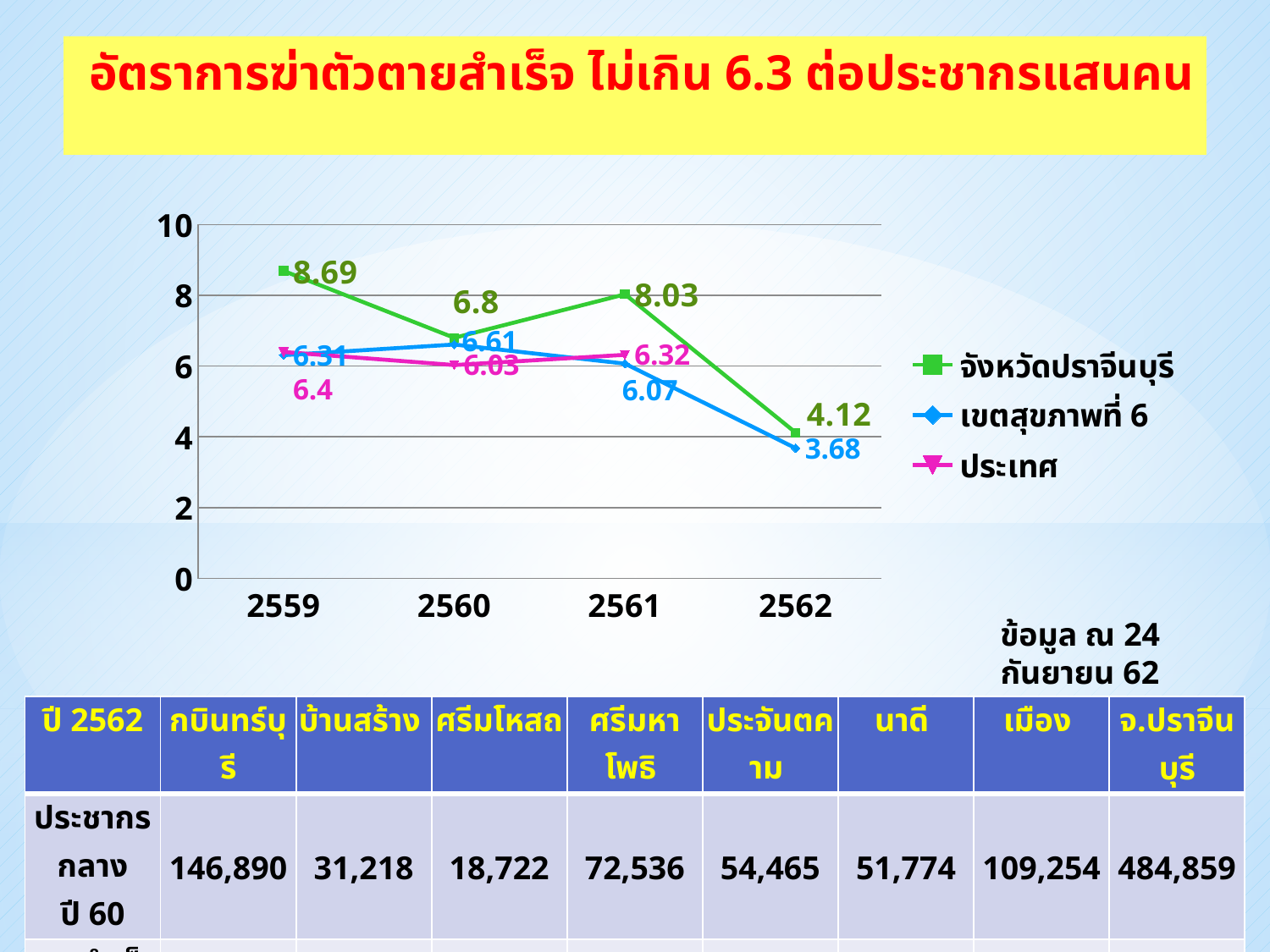
What is the value for เขตสุขภาพที่ 6 in 2562? 3.68 Which colour is used for the ประเทศ series in the chart? pink Which is larger in 2561, the value for จังหวัดปราจีนบุรี or the value for เขตสุขภาพที่ 6? จังหวัดปราจีนบุรี What is the difference between the จังหวัดปราจีนบุรี value and the เขตสุขภาพที่ 6 value in 2562? 0.44 In which year is the value for จังหวัดปราจีนบุรี the highest? 2559 What type of chart is shown on the slide? line chart What is the value for ประเทศ in 2560? 6.03 In which year is the value for จังหวัดปราจีนบุรี the lowest? 2562 How many series does the chart legend list? 3 What is the value for จังหวัดปราจีนบุรี in 2559? 8.69 Does the value for เขตสุขภาพที่ 6 rise or fall from 2561 to 2562? fall How many years are shown on the x axis of the chart? 4